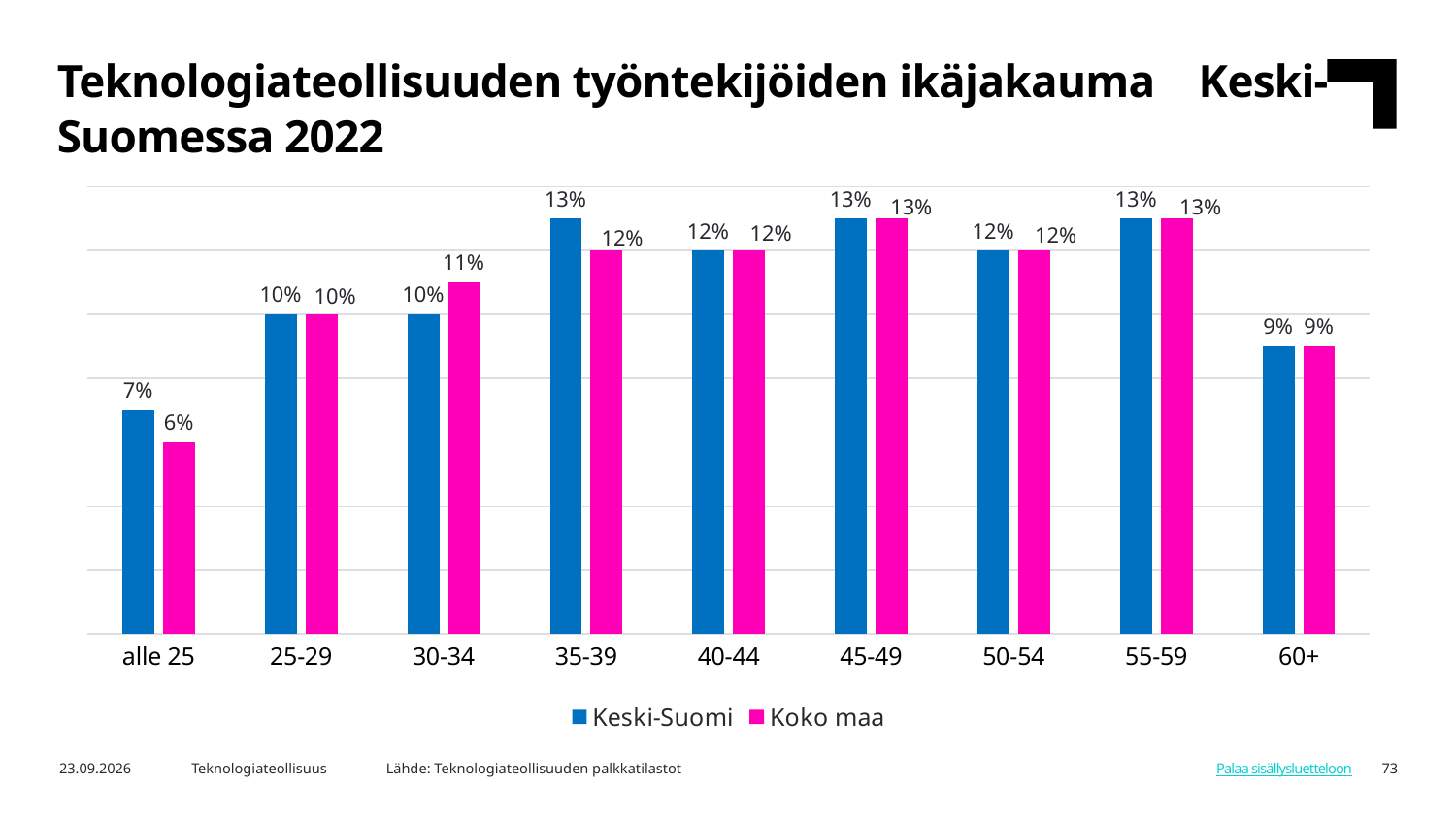
What is the value for Koko maa in the 60+ age group? 9% In the 30-34 age group, which series has the larger value, Keski-Suomi or Koko maa? Koko maa Which age group has the lowest value for Koko maa? alle 25 How many age groups are shown on the x axis? 9 What is the value for Keski-Suomi in the alle 25 age group? 7% What is the difference between the Keski-Suomi and Koko maa values in the alle 25 age group? 1 percentage point What is the value for Keski-Suomi in the 35-39 age group? 13% Which age group has the lowest value for Keski-Suomi? alle 25 What kind of chart is shown on the slide? Bar chart In the 35-39 age group, which series has the larger value, Keski-Suomi or Koko maa? Keski-Suomi What is the value for Koko maa in the 30-34 age group? 11% How many series does the legend list? 2